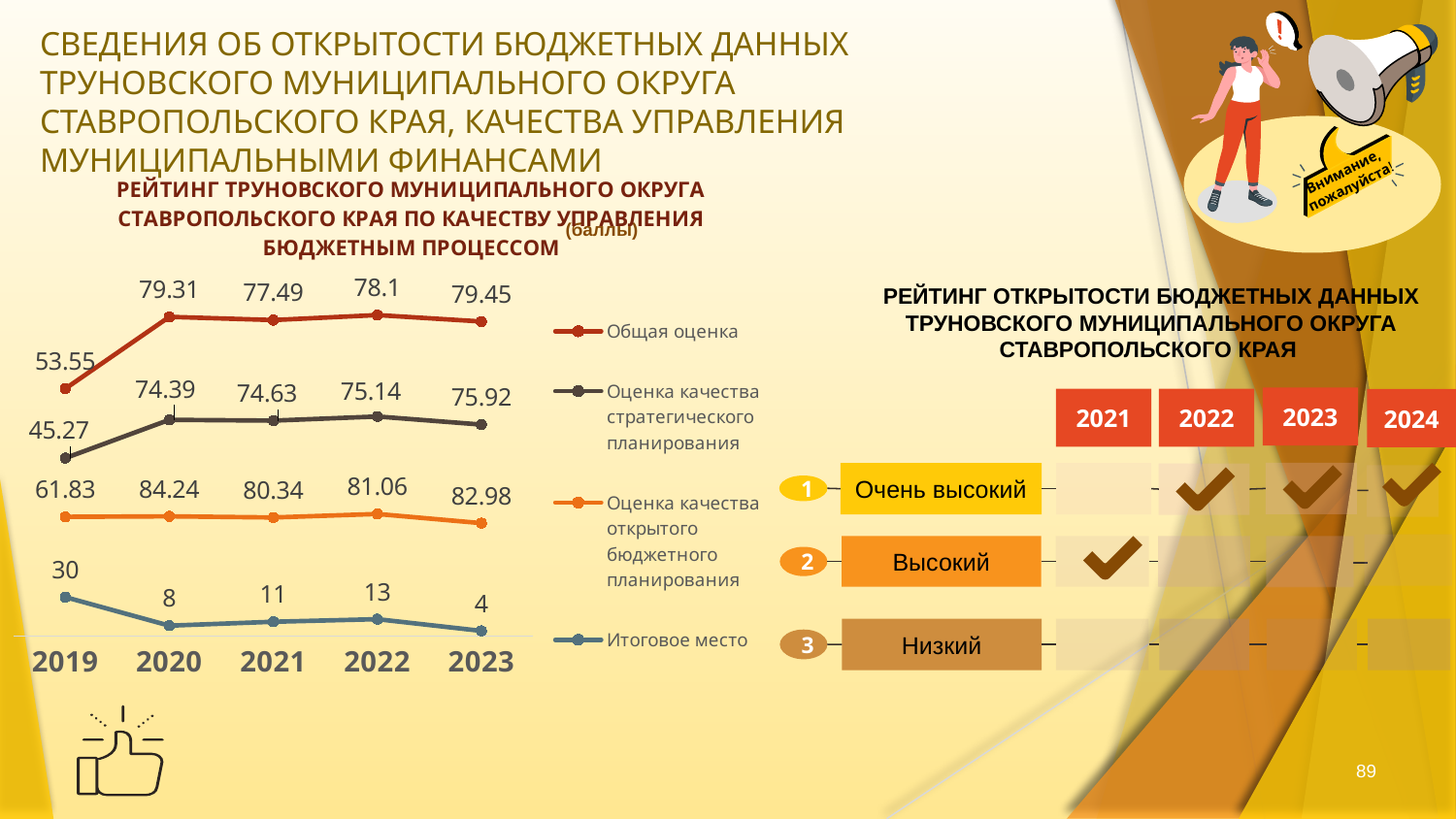
What is the Итоговое место in 2023? 4 What is the value of Общая оценка in 2019? 53.55 How many series does the legend of the line chart list? 4 What is the value of Оценка качества стратегического планирования in 2023? 75.92 In which year is Общая оценка the lowest? 2019 In which year is Оценка качества открытого бюджетного планирования the highest? 2020 What type of chart is shown on the left of the slide? line chart By how much did Общая оценка change from 2019 to 2020? 25.76 How many years are shown on the x axis of the line chart? 5 Does Оценка качества стратегического планирования rise or fall from 2020 to 2023? rise Which is larger in 2022: Общая оценка or Оценка качества стратегического планирования? Общая оценка What is the value of Оценка качества открытого бюджетного планирования in 2020? 84.24